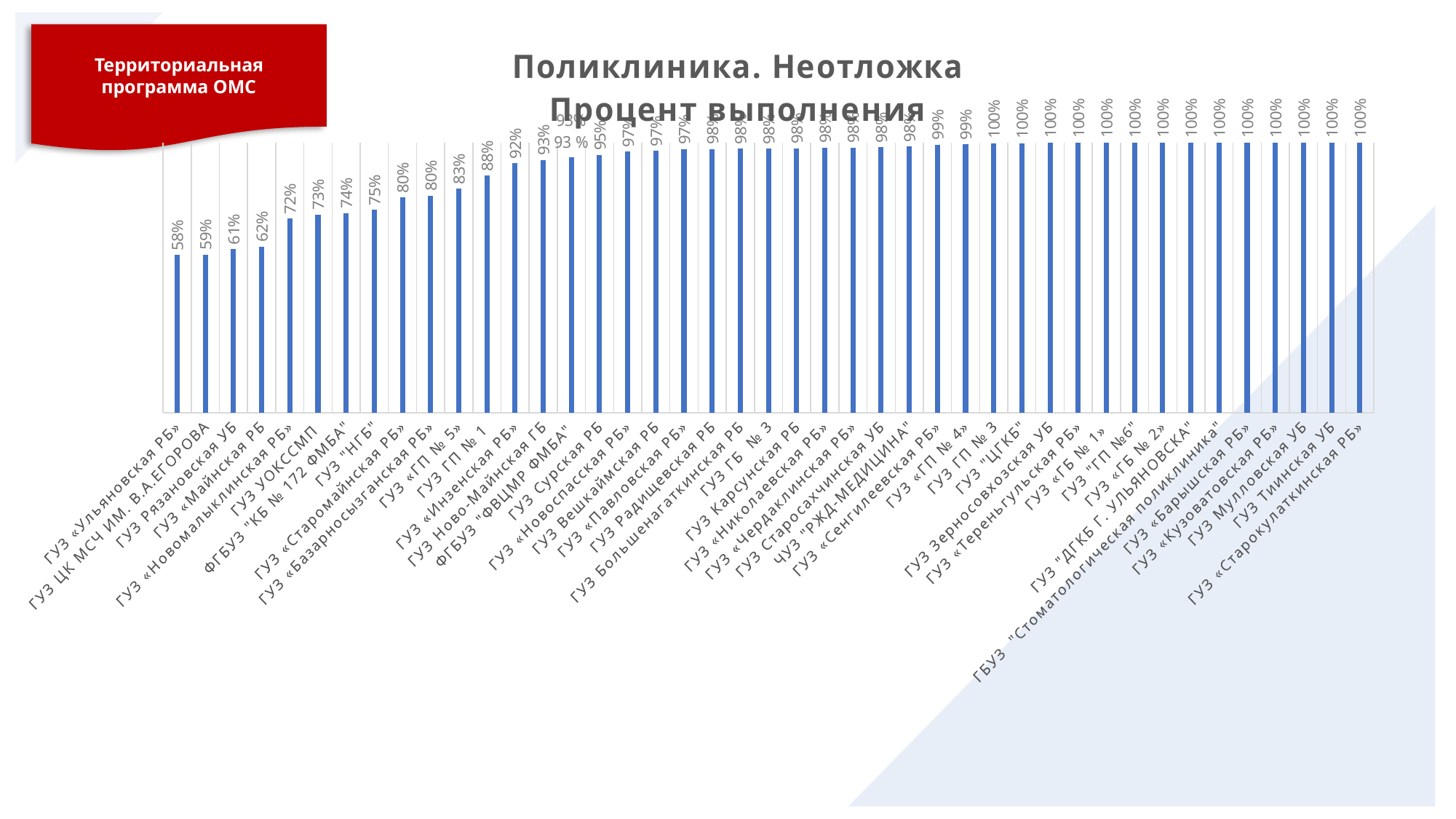
Which is larger, the value for ГУЗ УОКССМП or the value for ГУЗ Сурская РБ? ГУЗ Сурская РБ What is the value for ГУЗ «Сенгилеевская РБ»? 99% What is the value for ГУЗ «Барышская РБ»? 100% Do the values rise or fall from left to right along the x axis? Rise How many categories are shown on the x axis? 43 What is the value for ГУЗ ГП № 1? 88% What is the value for ГУЗ «Новомалыклинская РБ»? 72% What is the value for ГУЗ «Ульяновская РБ»? 58% Which category has the lowest value? ГУЗ «Ульяновская РБ» What kind of chart is this? Bar chart What is the title of the chart? Поликлиника. Неотложка Процент выполнения What is the difference between the values for ГУЗ «Инзенская РБ» and ГУЗ «Майнская РБ»? 30%